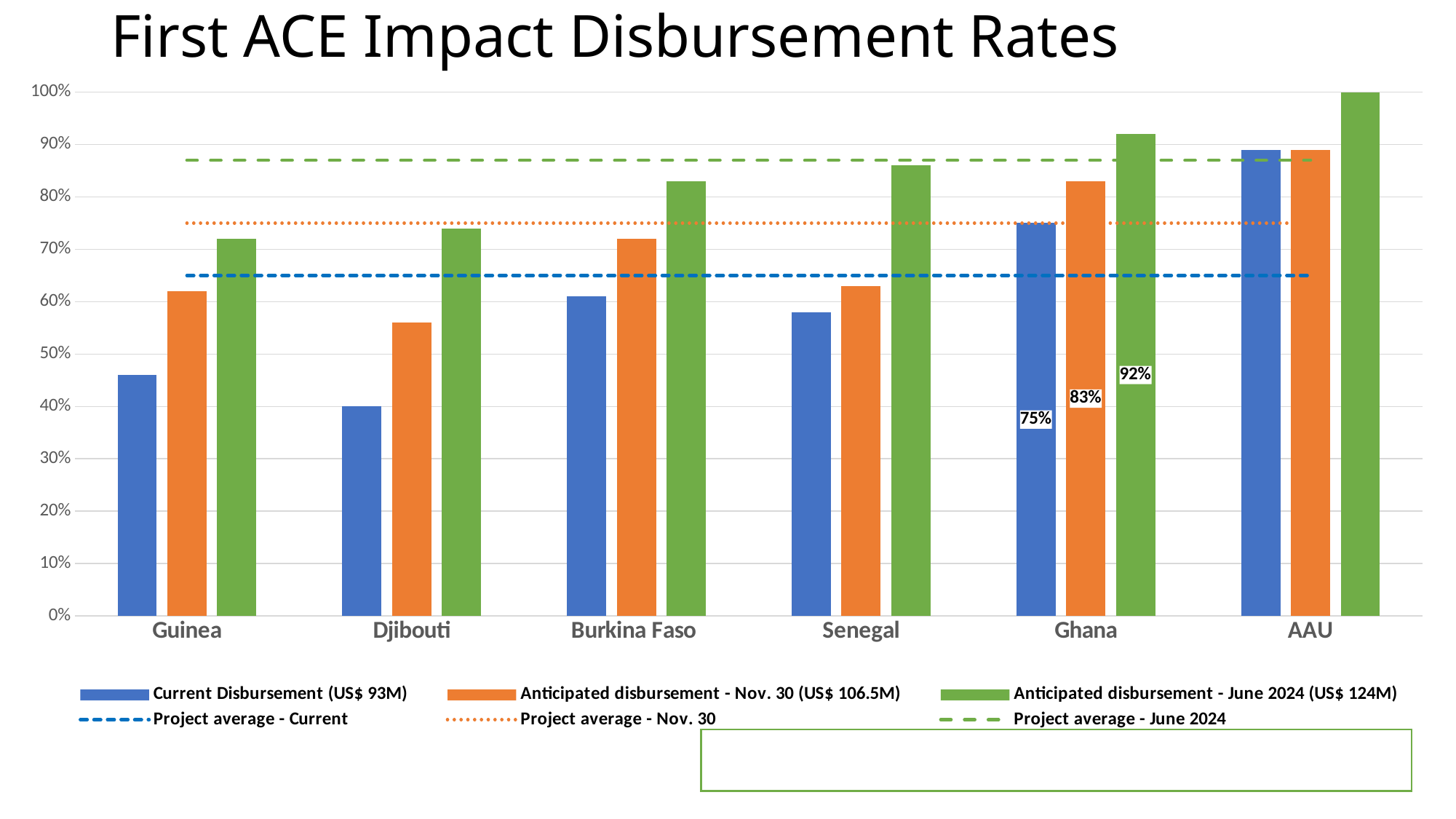
What is the Current Disbursement value for Ghana? 75% How many entries does the legend list? 6 Which is larger, the Current Disbursement for Guinea or for Djibouti? Guinea What is the Anticipated disbursement - June 2024 value for Ghana? 92% Is the Current Disbursement value for Guinea greater or less than 50%? less Which category has the highest Anticipated disbursement - June 2024 bar? AAU What is the Anticipated disbursement - Nov. 30 value for Ghana? 83% What type of chart is shown on the slide? Combination bar and line chart Is the Anticipated disbursement - June 2024 value for Burkina Faso greater or less than 80%? greater How many categories are shown on the x axis? 6 Which category has the lowest Current Disbursement bar? Djibouti For Ghana, what is the difference between the Anticipated disbursement - June 2024 value and the Current Disbursement value? 17 percentage points